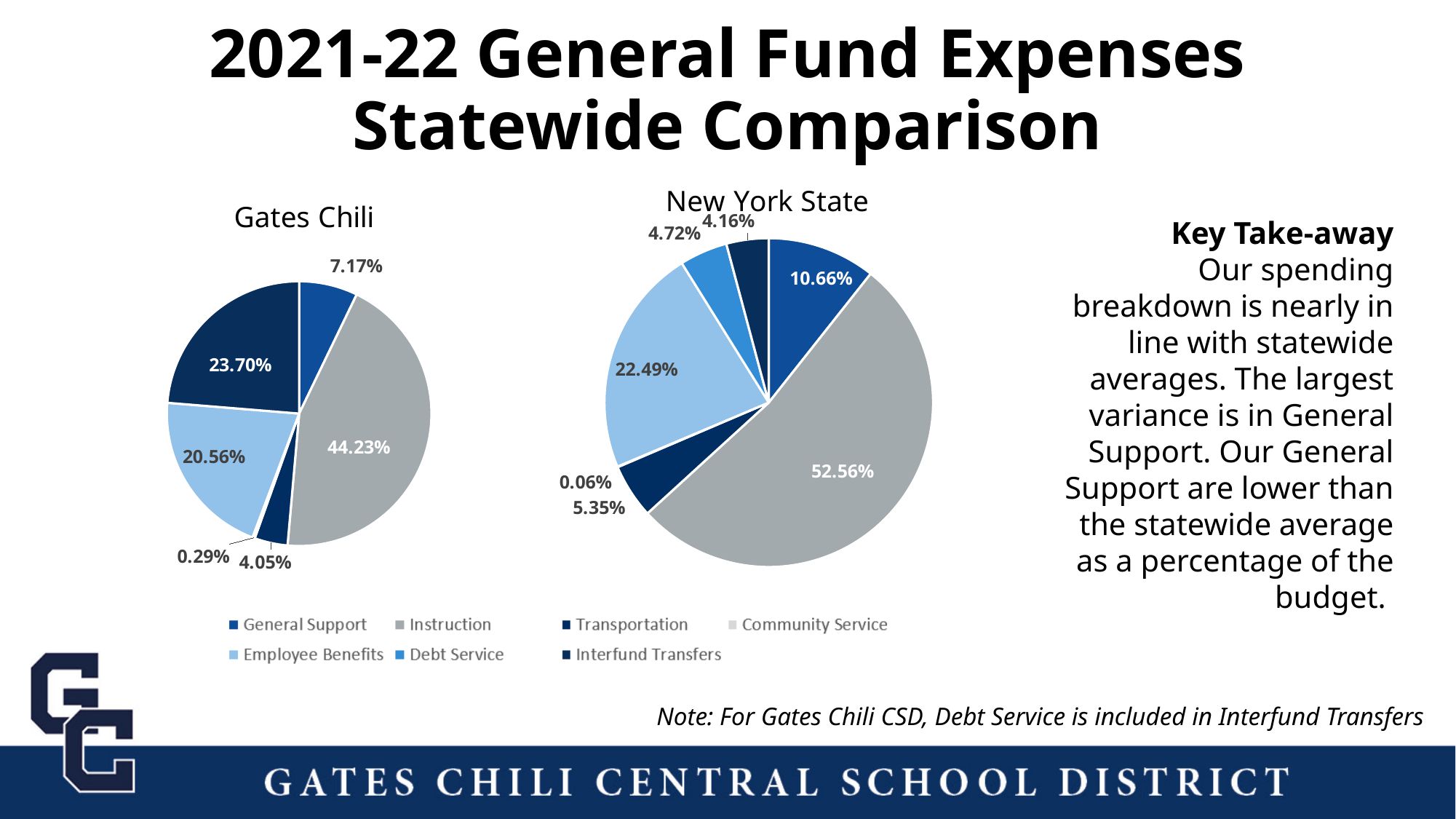
Which is larger: the General Support share in the Gates Chili chart or in the New York State chart? New York State In the Gates Chili chart, what share of expenses is General Support? 7.17% In the New York State chart, what share of expenses is Instruction? 52.56% What is the title of the pie chart on the right? New York State What type of charts are shown on the slide? Pie charts How many entries does the shared legend list? 7 In the Gates Chili chart, which category has the largest share? Instruction In the New York State chart, what share of expenses is Debt Service? 4.72% What is the difference between the Employee Benefits share in the New York State chart and in the Gates Chili chart? 1.93% In the New York State chart, which category has the smallest share? Community Service In the Gates Chili chart, what share of expenses is Instruction? 44.23% In the New York State chart, what share of expenses is General Support? 10.66%